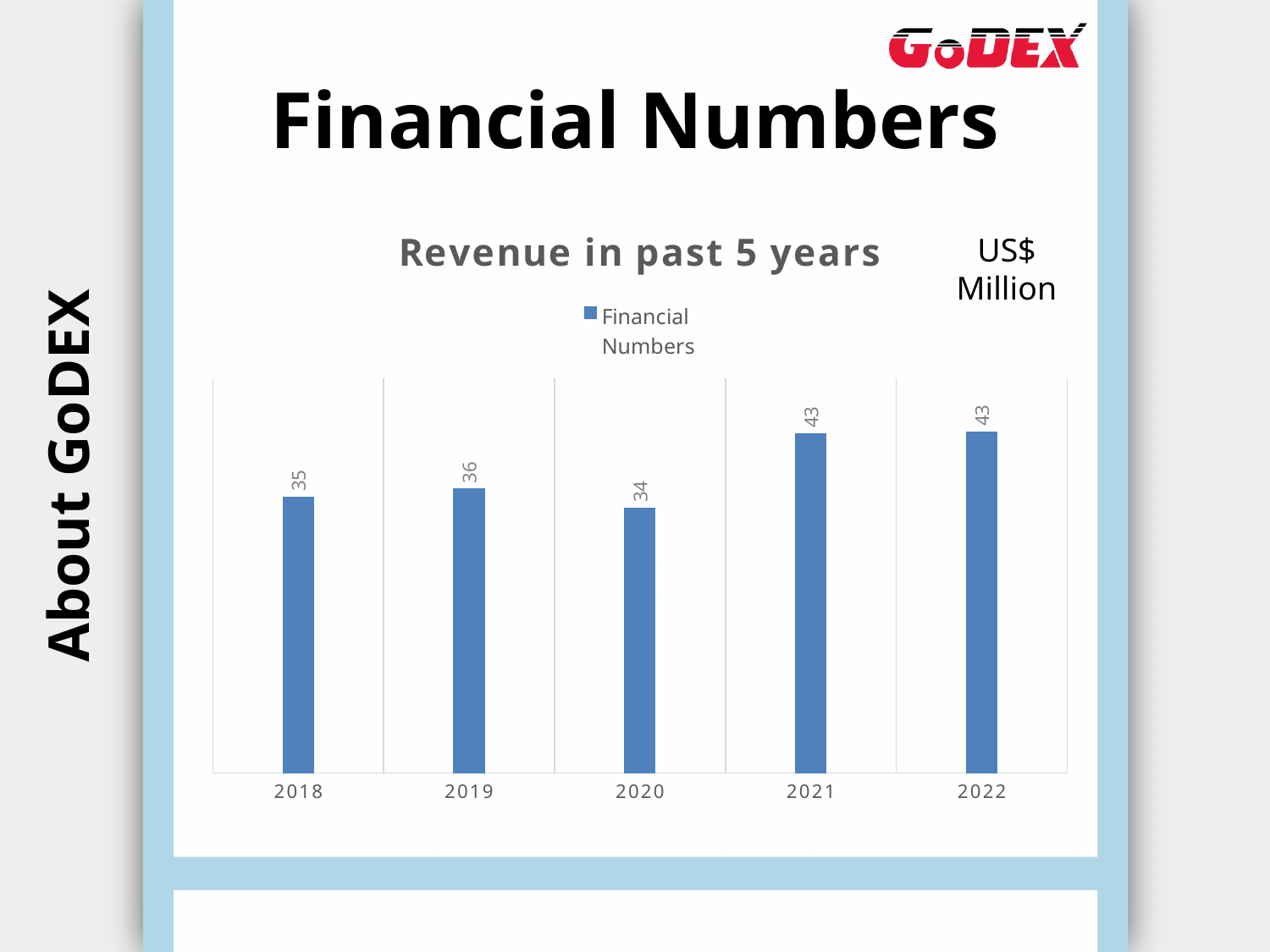
What is the difference between the revenue in 2021 and the revenue in 2018? 8 Which is larger, the revenue in 2019 or the revenue in 2020? 2019 Which year has the lowest revenue? 2020 How many series does the legend list? 1 What kind of chart is shown on the slide? bar chart What is the difference between the revenue in 2019 and the revenue in 2020? 2 What is the revenue value for 2021? 43 What is the revenue value for 2020? 34 What is the revenue value for 2018? 35 What unit is indicated for the chart values? US$ Million How many years are shown on the chart? 5 What is the title of the chart? Revenue in past 5 years